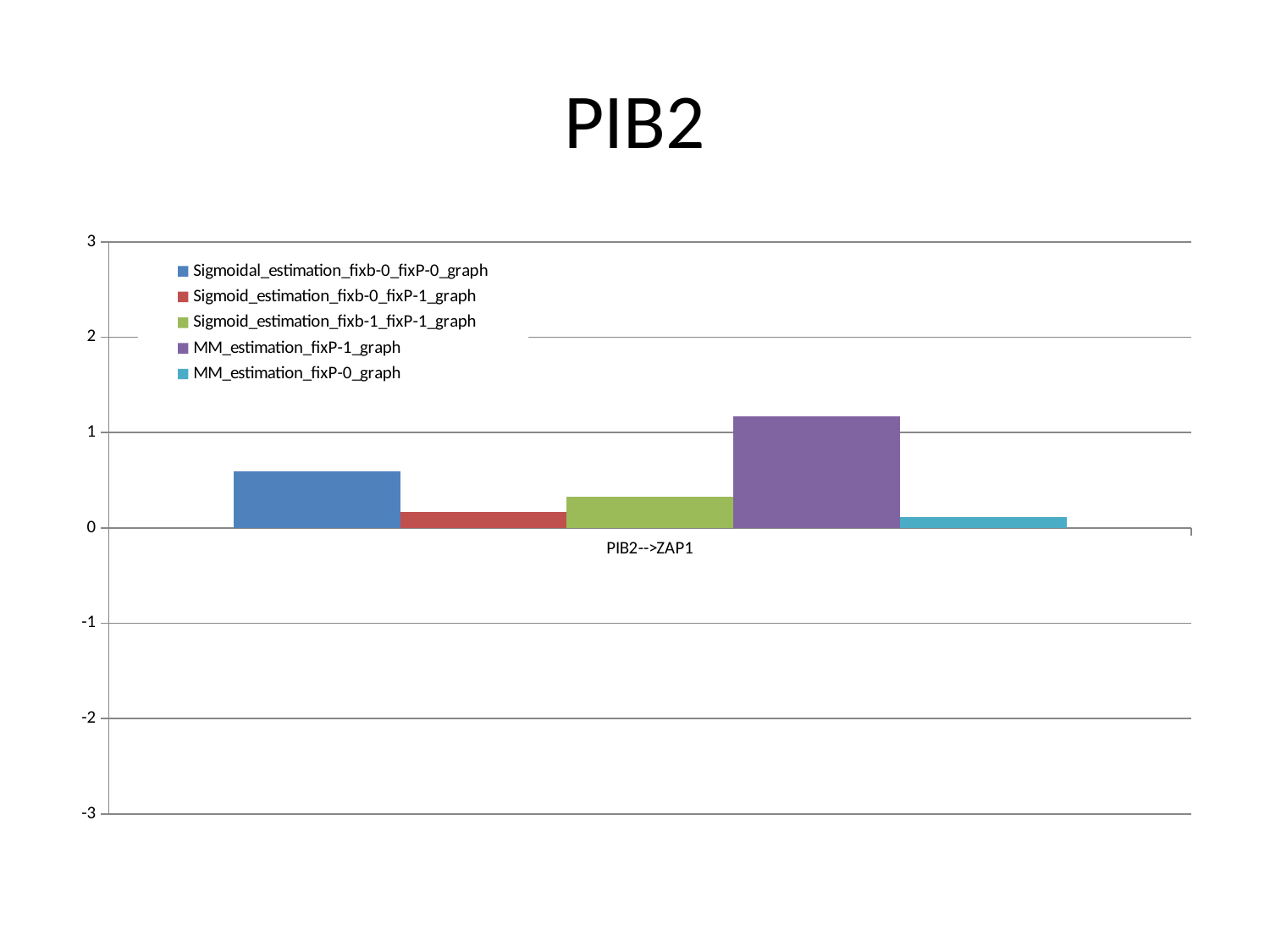
Is the value for MM_estimation_fixP-1_graph greater or less than 2? less Which is larger, the value for Sigmoidal_estimation_fixb-0_fixP-0_graph or the value for Sigmoid_estimation_fixb-1_fixP-1_graph? Sigmoidal_estimation_fixb-0_fixP-0_graph Which is larger, the value for MM_estimation_fixP-1_graph or the value for MM_estimation_fixP-0_graph? MM_estimation_fixP-1_graph Is the value for MM_estimation_fixP-1_graph greater or less than 1? greater How many categories are shown on the x axis? 1 Is the value for Sigmoidal_estimation_fixb-0_fixP-0_graph greater or less than 1? less Which is larger, the value for Sigmoid_estimation_fixb-1_fixP-1_graph or the value for Sigmoid_estimation_fixb-0_fixP-1_graph? Sigmoid_estimation_fixb-1_fixP-1_graph How many series does the legend list? 5 What is the title of the slide? PIB2 What kind of chart is shown on the slide? bar chart What is the category label shown on the x axis? PIB2-->ZAP1 Which series has the highest value for PIB2-->ZAP1? MM_estimation_fixP-1_graph